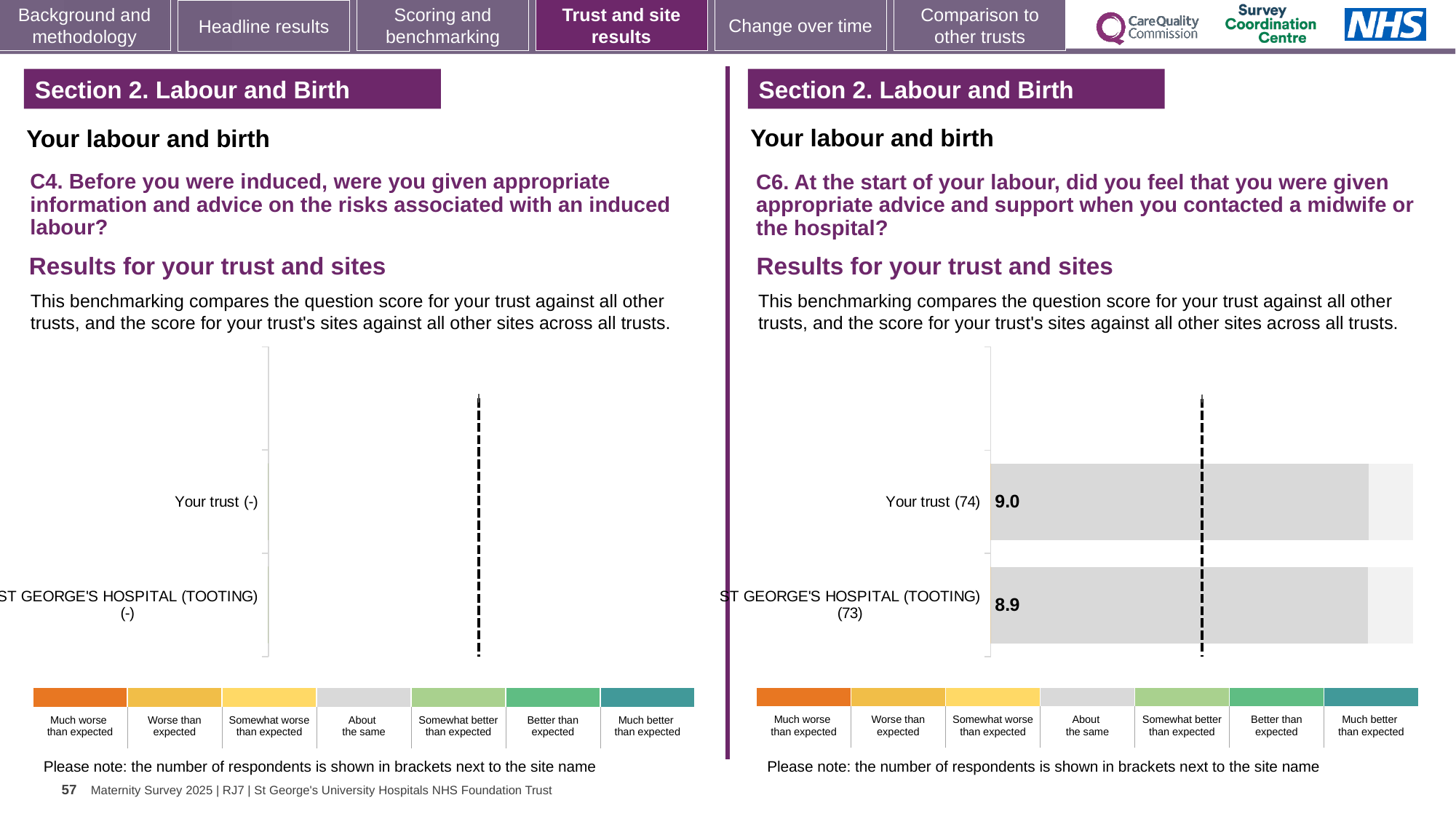
In the left-hand chart (C4), what is shown in brackets next to Your trust? - How many bars are plotted in the right-hand chart (C6)? 2 In the right-hand chart (C6), how many respondents are shown in brackets for St George's Hospital (Tooting)? 73 In the right-hand chart (C6), what is the score for Your trust? 9.0 In the right-hand chart (C6), what is the score for St George's Hospital (Tooting)? 8.9 In the right-hand chart (C6), which has the higher score, Your trust or St George's Hospital (Tooting)? Your trust In the right-hand chart (C6), which category has the lowest score? St George's Hospital (Tooting) In the right-hand chart (C6), how many respondents are shown in brackets for Your trust? 74 What type of chart is used in the right-hand chart (C6)? Bar chart How many categories does the colour key below each chart list, from 'Much worse than expected' to 'Much better than expected'? 7 In the right-hand chart (C6), what is the difference between the score for Your trust and the score for St George's Hospital (Tooting)? 0.1